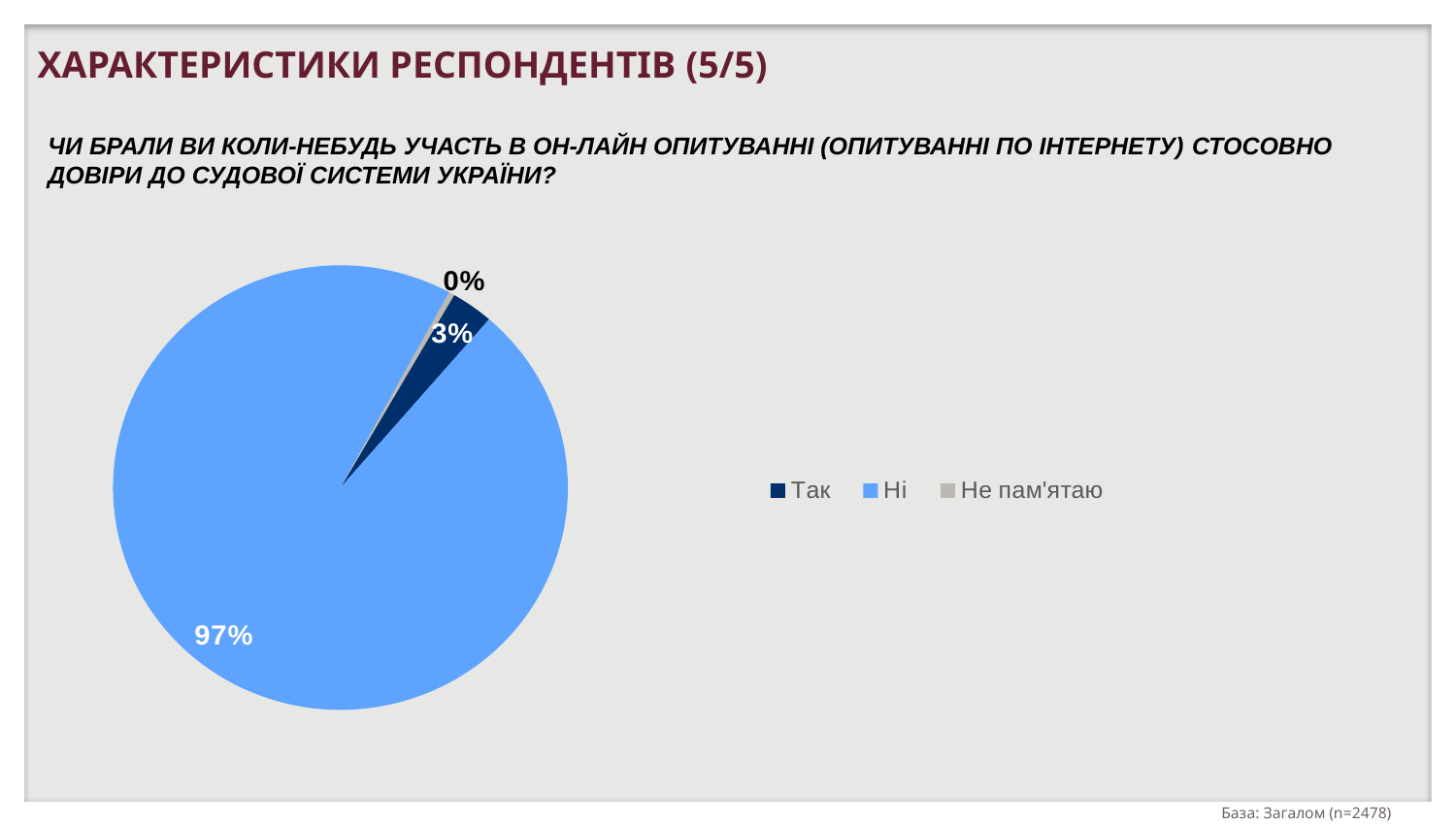
Which answer category has the smallest slice of the pie? Не пам'ятаю What share of respondents answered "Так"? 3% What share of respondents answered "Не пам'ятаю"? 0% What is the base (sample size) stated at the bottom of the slide? n=2478 Which slice is larger, "Так" or "Ні"? Ні What colour is the "Ні" slice of the pie? light blue Which answer category has the largest slice of the pie? Ні What is the difference in percentage points between the "Ні" and "Так" slices? 94 How many categories does the legend list? 3 What share of respondents answered "Ні"? 97% What kind of chart is shown on the slide? pie chart